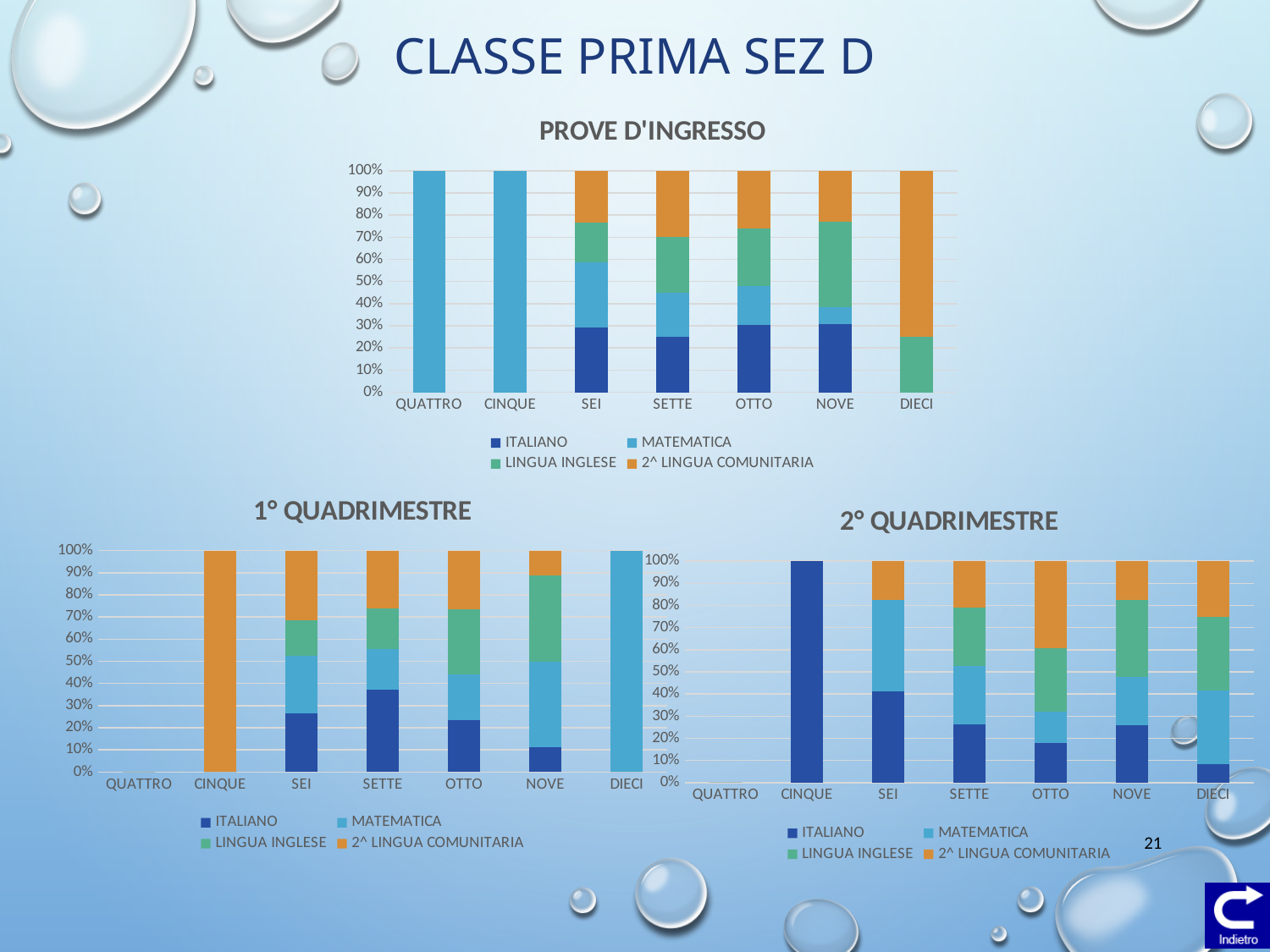
In the 1° QUADRIMESTRE chart, which series makes up the entire bar for CINQUE? 2^ LINGUA COMUNITARIA In the 2° QUADRIMESTRE chart, is the 2^ LINGUA COMUNITARIA value for OTTO greater or less than 30%? greater In the 1° QUADRIMESTRE chart, is the ITALIANO value for NOVE greater or less than 20%? less In the PROVE D'INGRESSO chart, what is the MATEMATICA value for QUATTRO? 100% What kind of chart is the PROVE D'INGRESSO chart? stacked bar chart In the 2° QUADRIMESTRE chart, is the ITALIANO value for DIECI greater or less than 20%? less How many categories are shown on the x axis of the PROVE D'INGRESSO chart? 7 In the 2° QUADRIMESTRE chart, which series makes up the entire bar for CINQUE? ITALIANO In the 1° QUADRIMESTRE chart, what is the MATEMATICA value for DIECI? 100% How many series does the legend of the 1° QUADRIMESTRE chart list? 4